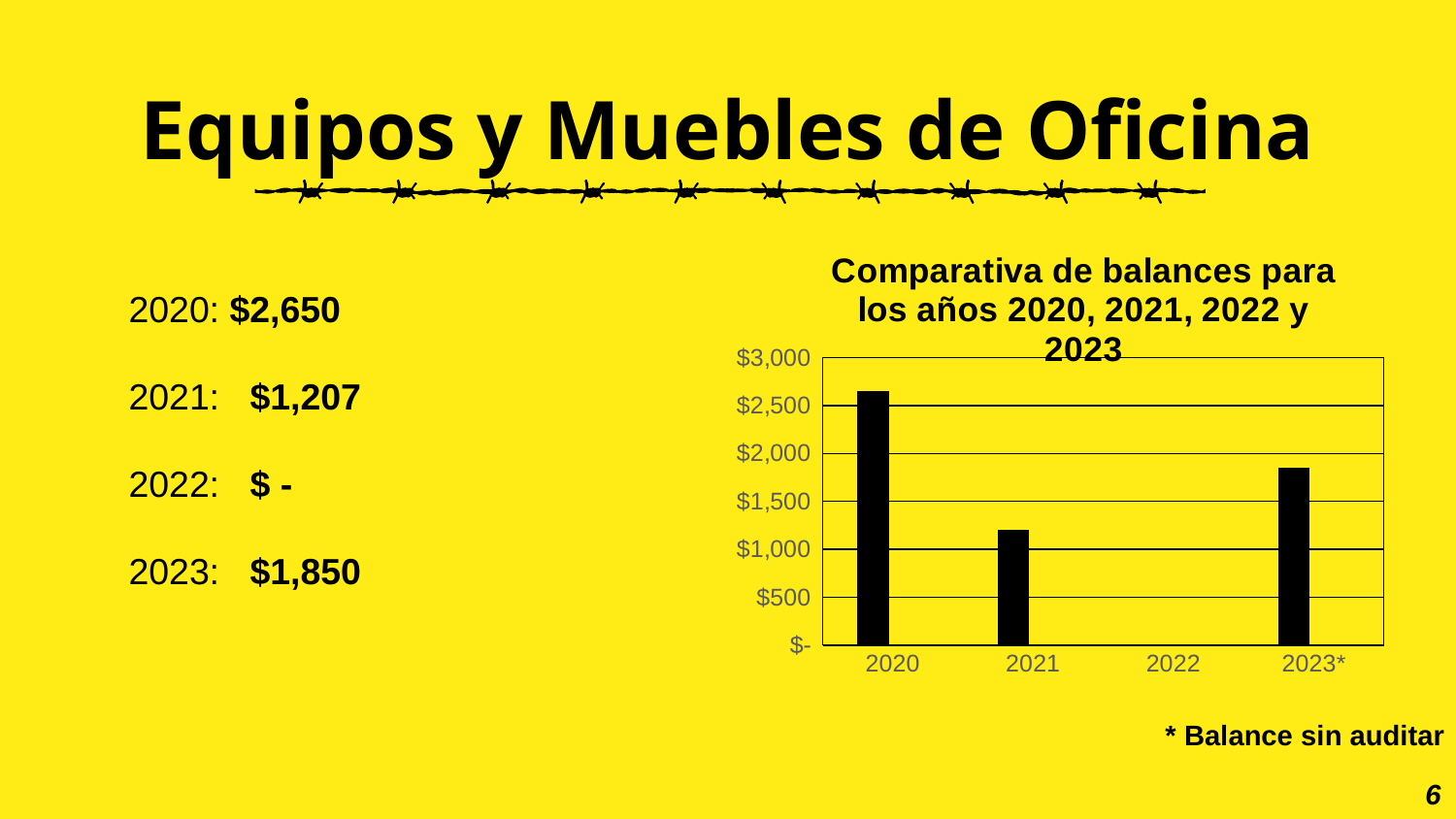
Which year has the highest balance in the chart? 2020 How many years are shown on the x axis of the chart? 4 Is the value for 2020 greater or less than $2,500? greater Which year has the lowest balance in the chart? 2022 What is the difference between the balance for 2020 and the balance for 2023? $800 What kind of chart is shown on the slide? bar chart What is the title of the chart? Comparativa de balances para los años 2020, 2021, 2022 y 2023 What is the balance for 2023? $1,850 Is the value for 2021 greater or less than $1,500? less What is the balance for 2021? $1,207 What is the balance for 2020? $2,650 Which is larger, the balance for 2021 or the balance for 2023? 2023